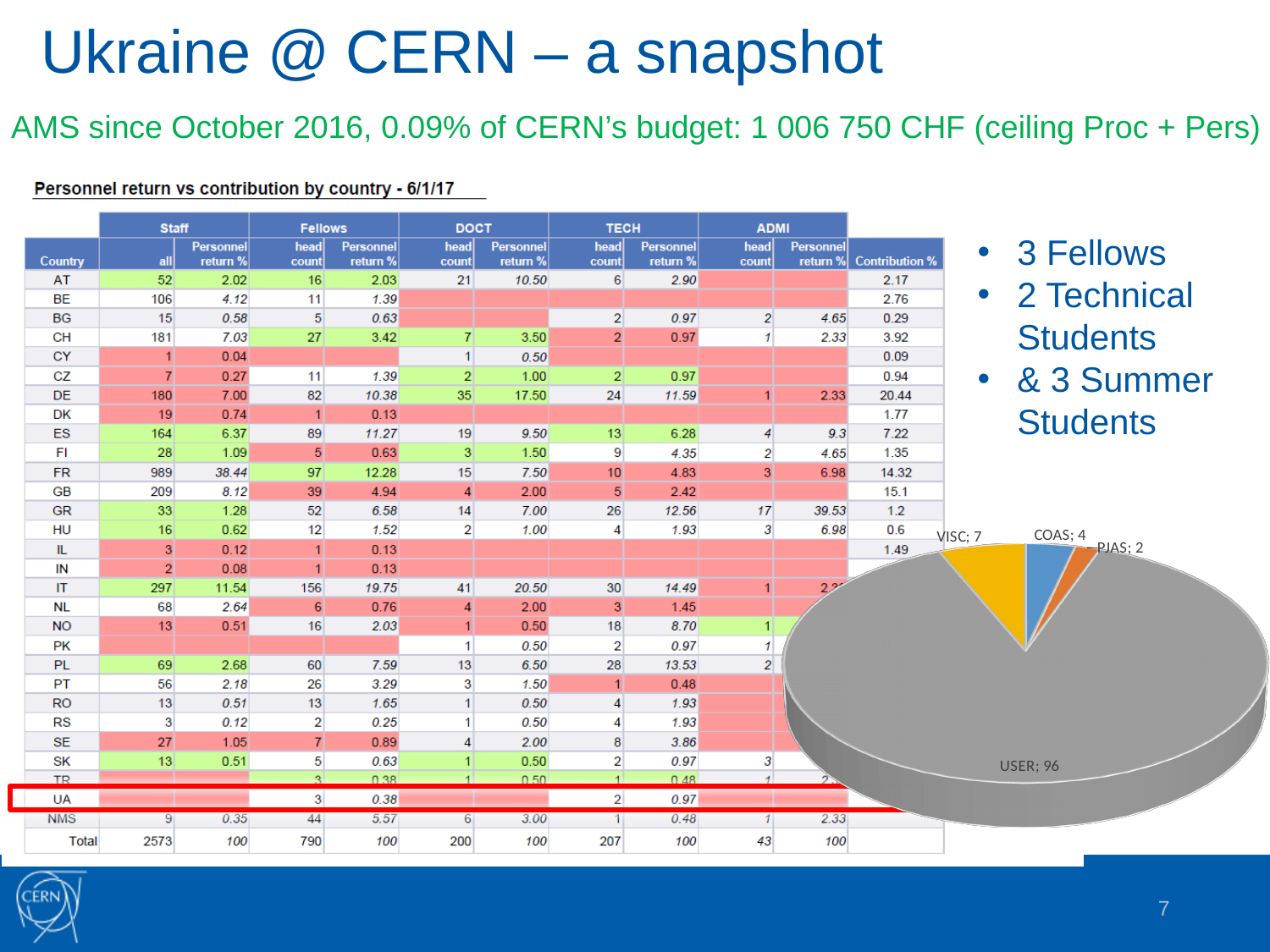
In the pie chart, what is the difference between the USER value and the VISC value? 89 What colour is the USER slice in the pie chart? Grey In the pie chart, what is the difference between the VISC value and the COAS value? 3 In the pie chart, what is the value for COAS? 4 In the pie chart, which is larger, COAS or PJAS? COAS In the pie chart, what is the value for VISC? 7 Which category has the largest slice in the pie chart? USER What kind of chart is shown at the bottom right of the slide? Pie chart Which category has the smallest slice in the pie chart? PJAS How many slices does the pie chart have? 4 In the pie chart, what is the value for PJAS? 2 In the pie chart, what is the value for USER? 96